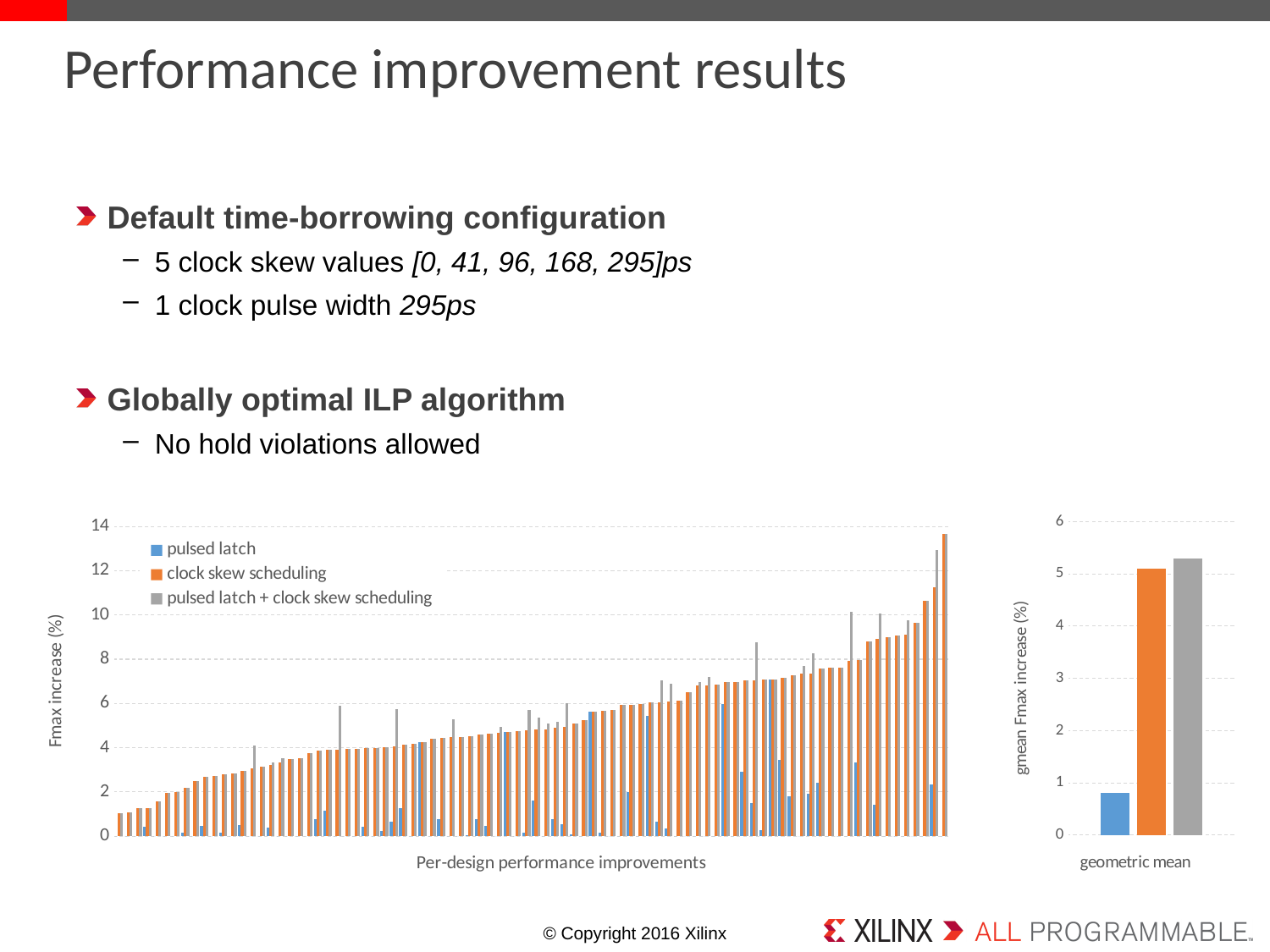
In the Per-design performance improvements chart, do the clock skew scheduling values generally rise or fall from left to right along the x axis? rise In the geometric mean chart, which series has the lowest gmean Fmax increase? pulsed latch What is the maximum value shown on the y axis of the Per-design performance improvements chart? 14 In the geometric mean chart, is the value for pulsed latch + clock skew scheduling greater or less than 4? greater What kind of chart is the Per-design performance improvements chart? bar chart In the geometric mean chart, is the value for pulsed latch greater or less than 1? less What is the y-axis label of the geometric mean chart? gmean Fmax increase (%) In the Per-design performance improvements chart, is the tallest bar greater or less than 12? greater What is the y-axis label of the Per-design performance improvements chart? Fmax increase (%) In the geometric mean chart, which is larger: the value for pulsed latch or the value for clock skew scheduling? clock skew scheduling How many series does the legend of the Per-design performance improvements chart list? 3